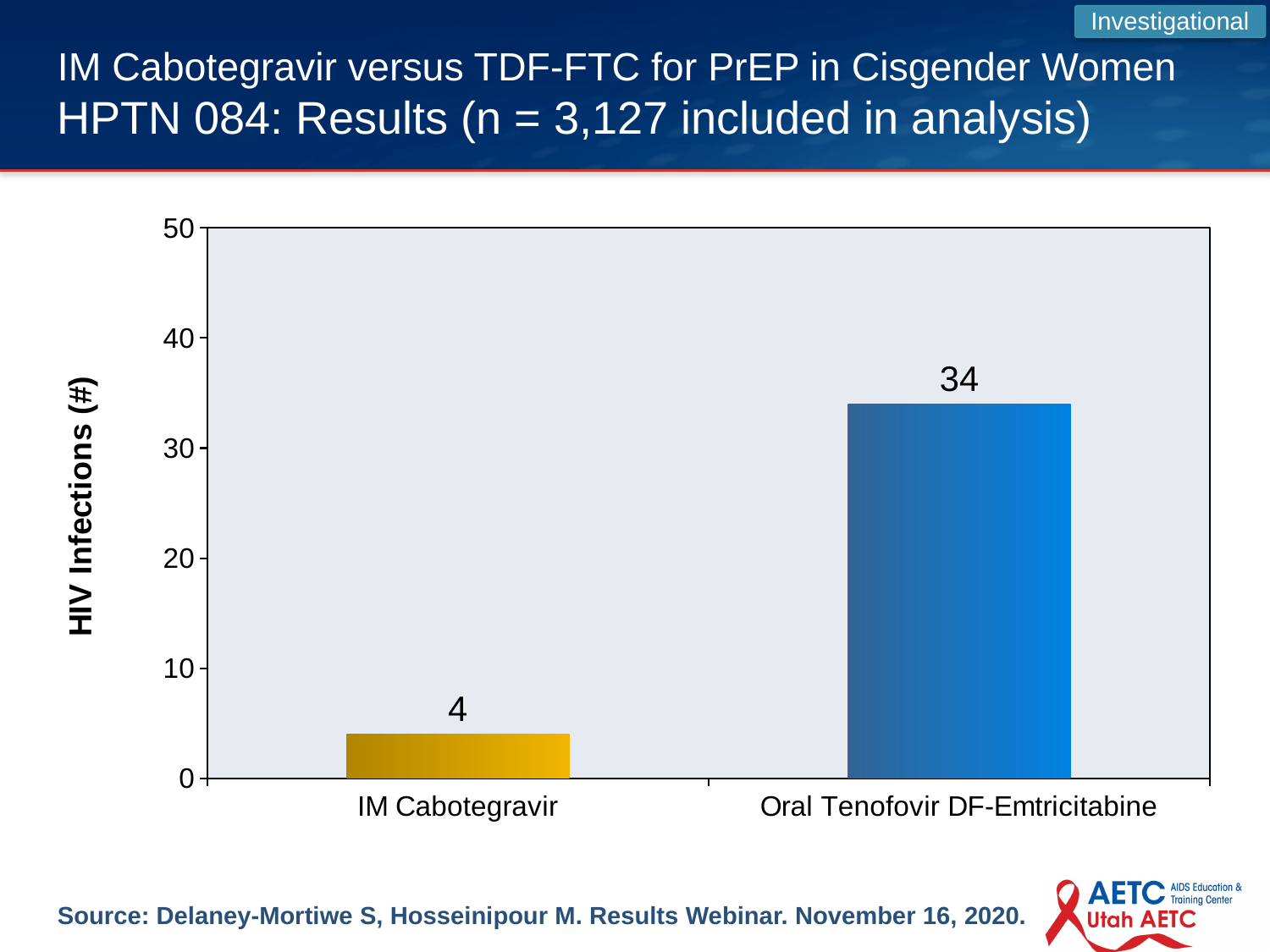
What is the maximum value shown on the y axis? 50 Is the value for IM Cabotegravir greater or less than 10? less Is the value for Oral Tenofovir DF-Emtricitabine greater or less than 30? greater Which has more HIV infections, IM Cabotegravir or Oral Tenofovir DF-Emtricitabine? Oral Tenofovir DF-Emtricitabine What is the label of the y axis? HIV Infections (#) Which group has the lower number of HIV infections? IM Cabotegravir What kind of chart is shown on the slide? Bar chart Which group has the higher number of HIV infections? Oral Tenofovir DF-Emtricitabine How many HIV infections are shown for IM Cabotegravir? 4 How many HIV infections are shown for Oral Tenofovir DF-Emtricitabine? 34 How many categories are plotted on the chart? 2 What is the difference in HIV infections between Oral Tenofovir DF-Emtricitabine and IM Cabotegravir? 30